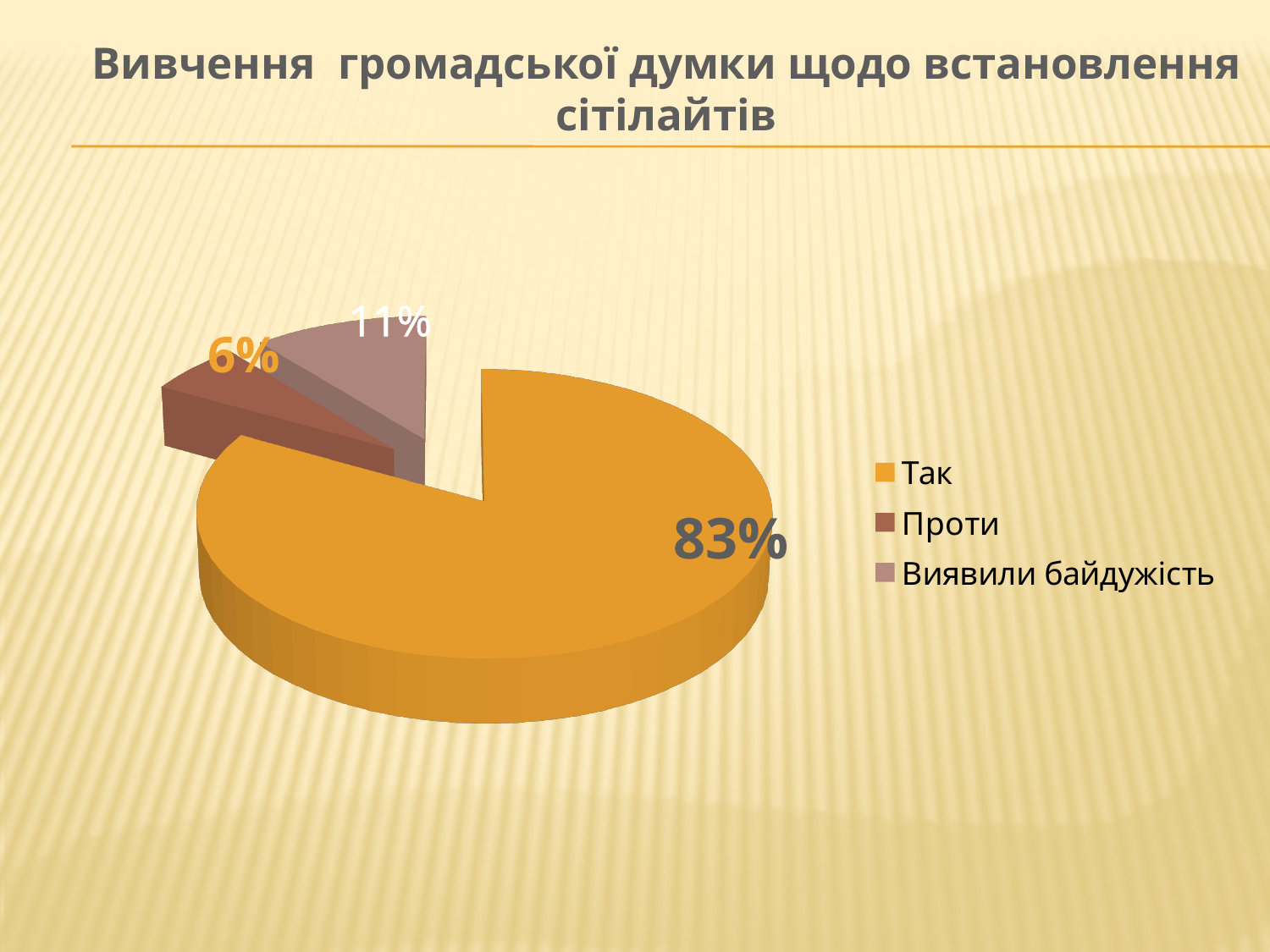
What kind of chart is shown on the slide? Pie chart What is the difference in percentage points between the "Виявили байдужість" slice and the "Проти" slice? 5 What percentage is shown for the "Проти" slice? 6% What is the difference in percentage points between the "Так" slice and the "Виявили байдужість" slice? 72 How many entries does the legend list? 3 What percentage of the pie is labelled for the "Так" slice? 83% What is the title of the slide containing the chart? Вивчення громадської думки щодо встановлення сітілайтів How many slices does the pie chart have? 3 Which category has the smallest share of the pie? Проти Which is larger, the "Проти" slice or the "Виявили байдужість" slice? Виявили байдужість What percentage is shown for the "Виявили байдужість" slice? 11% Which category has the largest share of the pie? Так